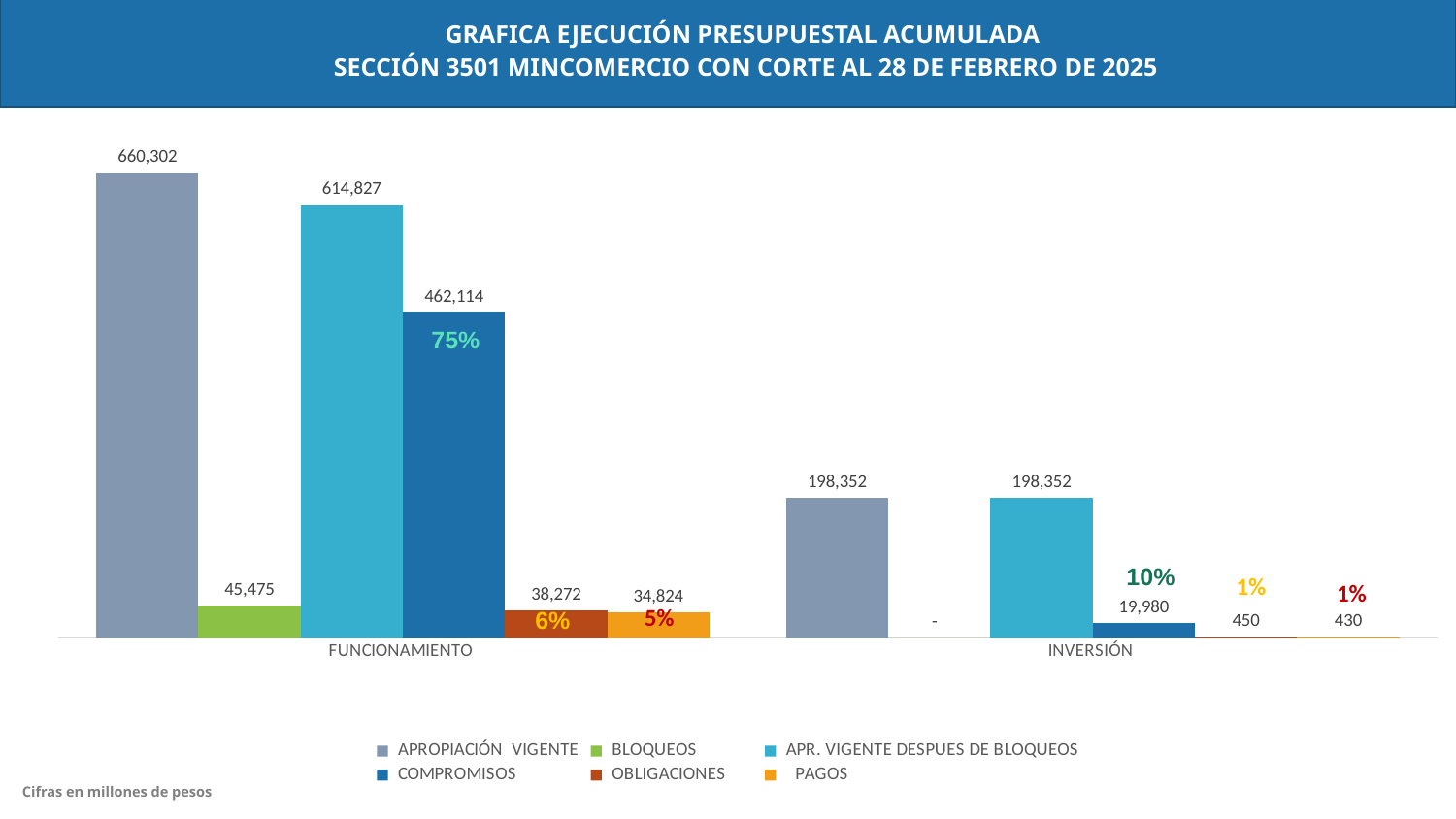
What percentage is shown on the COMPROMISOS bar for FUNCIONAMIENTO? 75% How many series does the legend list? 6 What is the value of PAGOS for INVERSIÓN? 430 What is the difference between APROPIACIÓN VIGENTE and APR. VIGENTE DESPUES DE BLOQUEOS for FUNCIONAMIENTO? 45,475 What is the value of BLOQUEOS for FUNCIONAMIENTO? 45,475 Which is larger: OBLIGACIONES for FUNCIONAMIENTO or PAGOS for FUNCIONAMIENTO? OBLIGACIONES What is the value of COMPROMISOS for INVERSIÓN? 19,980 Which series has the lowest value for INVERSIÓN (excluding the dash for BLOQUEOS)? PAGOS Which series has the highest value for FUNCIONAMIENTO? APROPIACIÓN VIGENTE What kind of chart is shown on the slide? Bar chart What is the value of APROPIACIÓN VIGENTE for FUNCIONAMIENTO? 660,302 How many categories are shown on the x axis? 2